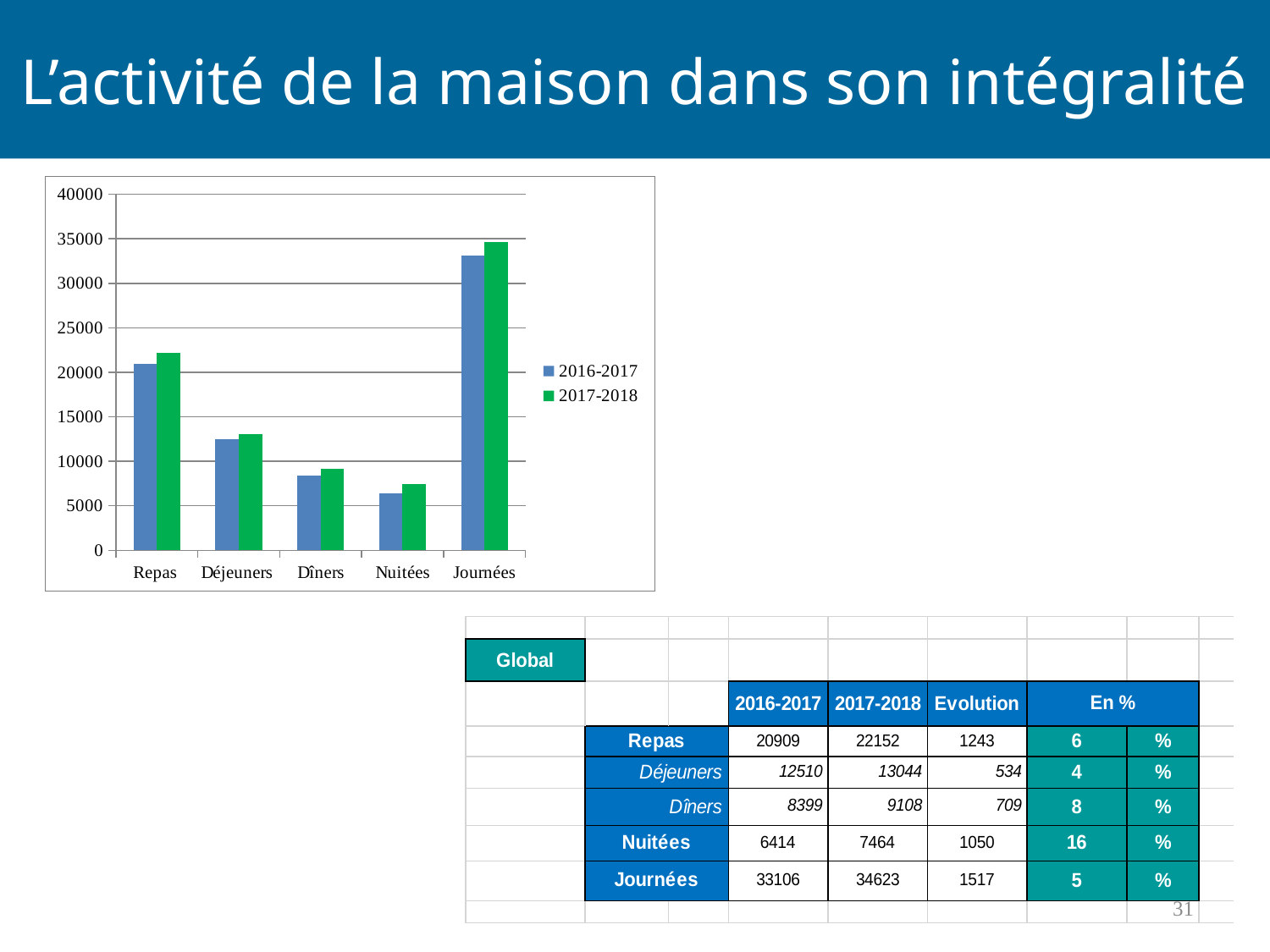
According to the table on the slide, what is the 2016-2017 value for Nuitées? 6414 Is the 2016-2017 value for Dîners greater or less than 10000? less According to the table on the slide, what is the 2017-2018 value for Repas? 22152 What kind of chart is shown on the slide? bar chart How many series does the chart legend list? 2 Is the 2017-2018 value for Journées greater or less than 30000? greater Which category has the highest bars in the chart? Journées Which series is shown in green in the chart? 2017-2018 Using the values printed in the table, what is the difference between the 2017-2018 and 2016-2017 values for Journées? 1517 Which category has the lowest bars in the chart? Nuitées Which is larger for Déjeuners: the 2016-2017 bar or the 2017-2018 bar? 2017-2018 How many categories are shown on the x axis of the chart? 5